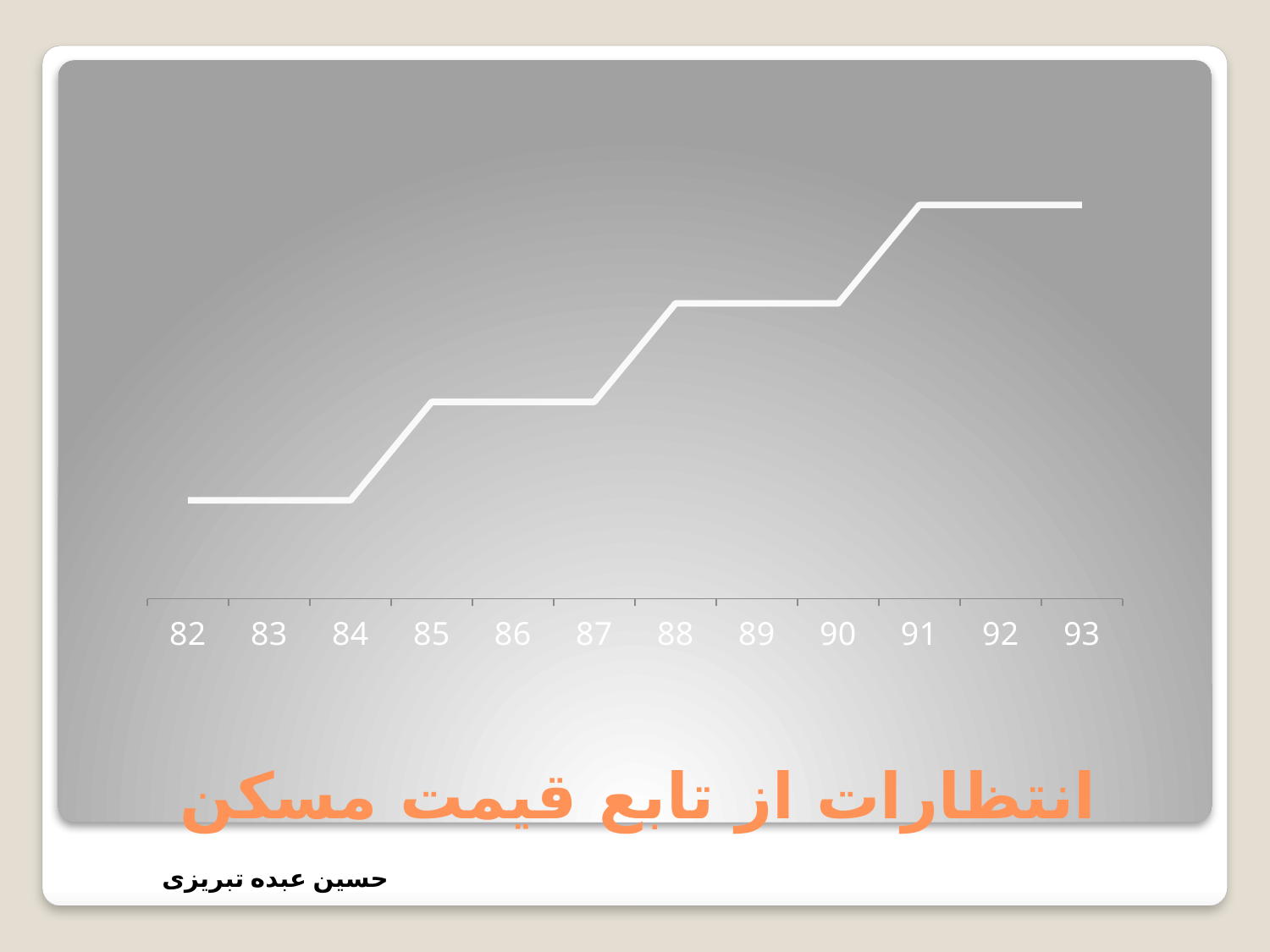
Do the values in the chart generally rise or fall from 82 to 93 along the x axis? rise Which has the higher value in the chart, 90 or 91? 91 What is the last category label on the x axis of the chart? 93 Which has the higher value in the chart, 82 or 93? 93 What is the first category label on the x axis of the chart? 82 How many categories are labelled on the x axis of the chart? 12 Which has the higher value in the chart, 84 or 85? 85 What kind of chart is shown on the slide? line chart